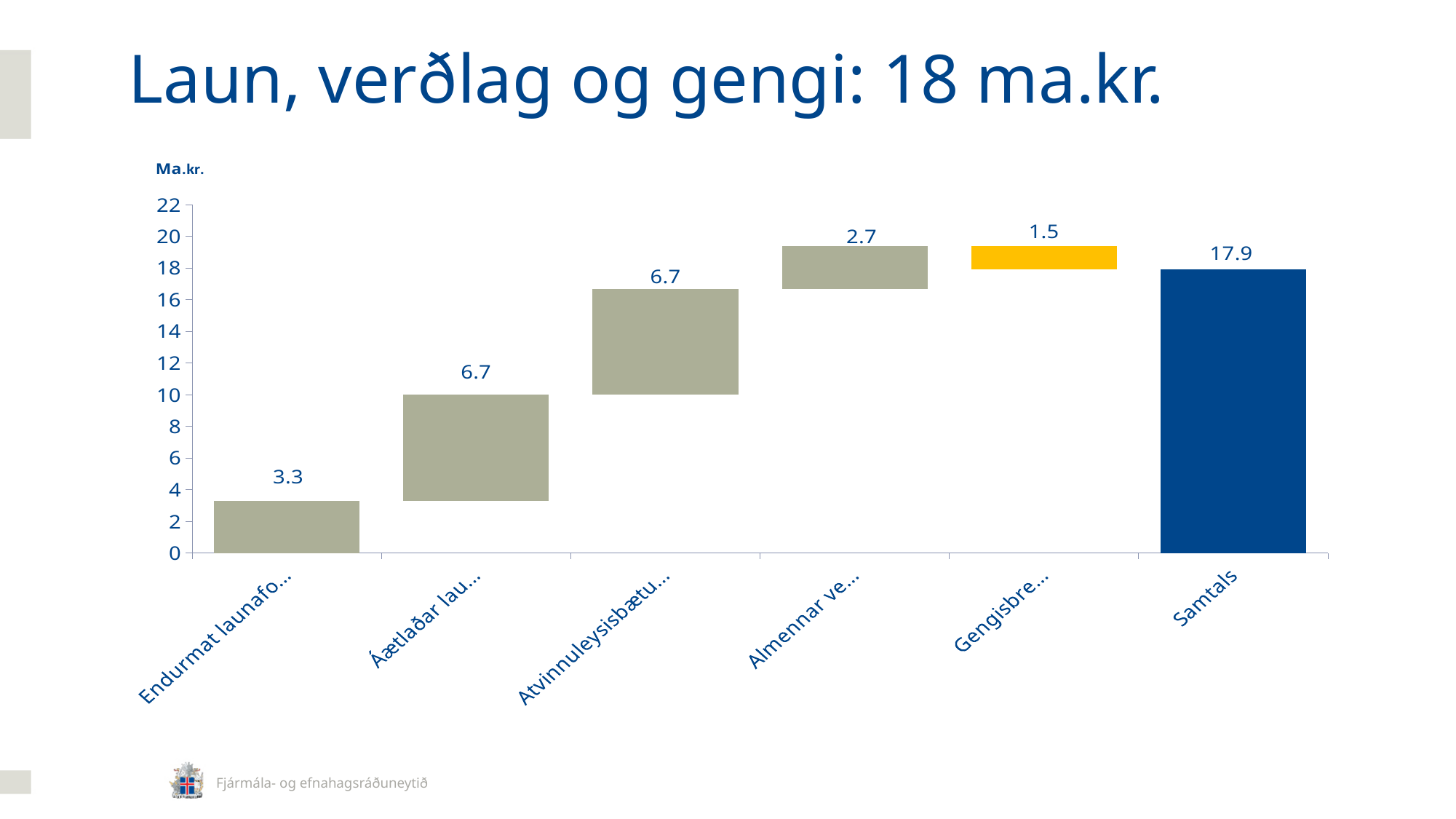
What kind of chart is shown on the slide? bar chart What value is labelled on the yellow bar? 1.5 What is the difference between the value of the fourth bar (2.7) and the yellow bar (1.5)? 1.2 Which is larger, the value of the first bar or the value of the fourth bar? the first bar What unit label is shown above the vertical axis? Ma.kr. What is the value shown for the Samtals bar? 17.9 Which bar has the highest value in the chart? Samtals How many bars are plotted in the chart? 6 What is the smallest value labelled on any bar in the chart? 1.5 What value is labelled on the fourth bar from the left? 2.7 What is the difference between the Samtals value and the value of the first bar? 14.6 What value is labelled on the first (leftmost) bar of the chart? 3.3